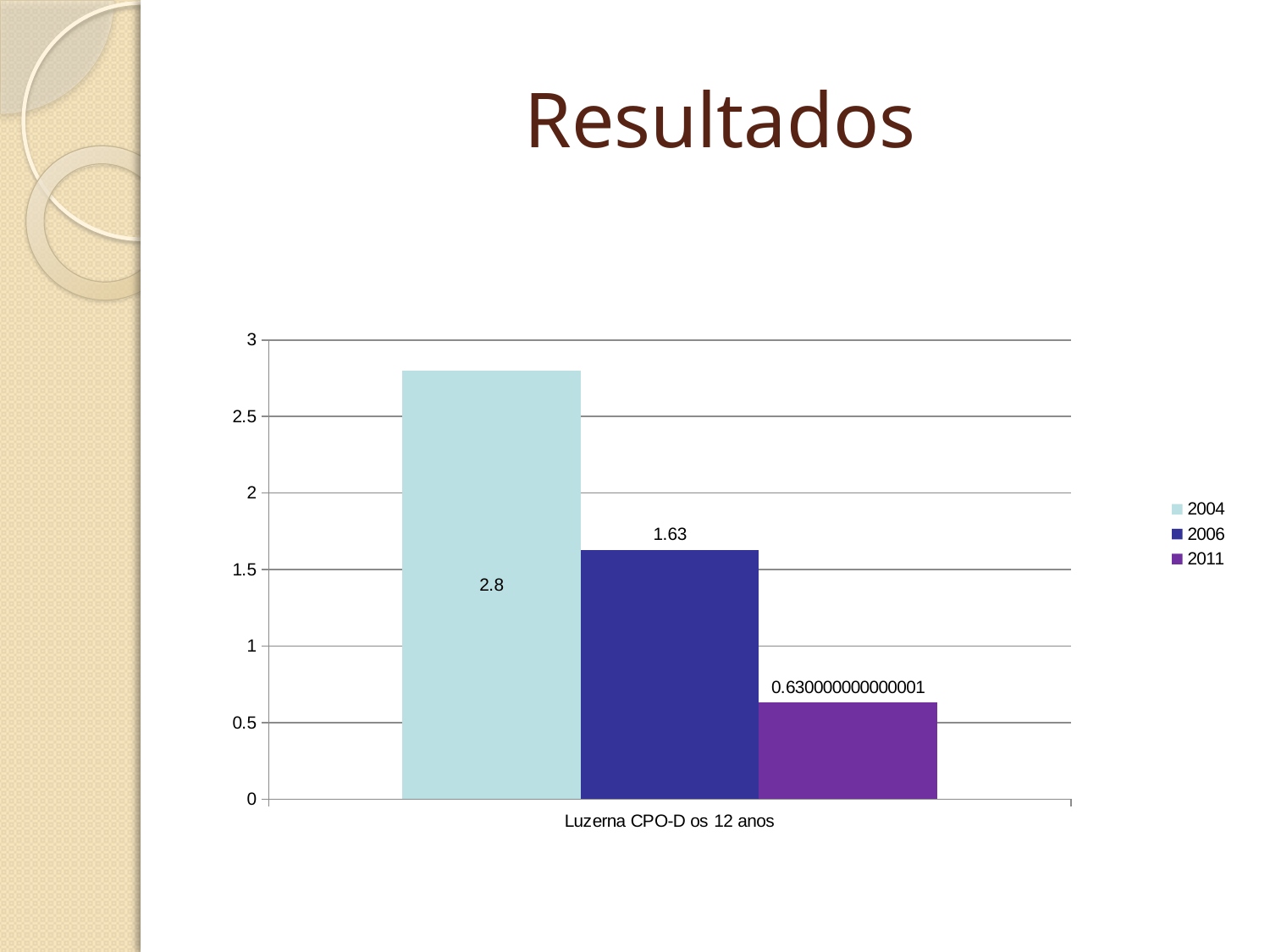
Which year has the highest value? 2004 Which year has the lowest value? 2011 How many series does the legend list? 3 What value is printed on the 2011 bar? 0.630000000000001 What kind of chart is shown on the slide? bar chart What is the category label shown on the x axis? Luzerna CPO-D os 12 anos What is the value for 2004 in the chart? 2.8 Is the value for 2004 greater or less than 2.5? greater Is the value for 2011 greater or less than 1? less Which is larger, the value for 2006 or the value for 2011? 2006 What is the value for 2006 in the chart? 1.63 What is the difference between the 2004 and 2006 values? 1.17